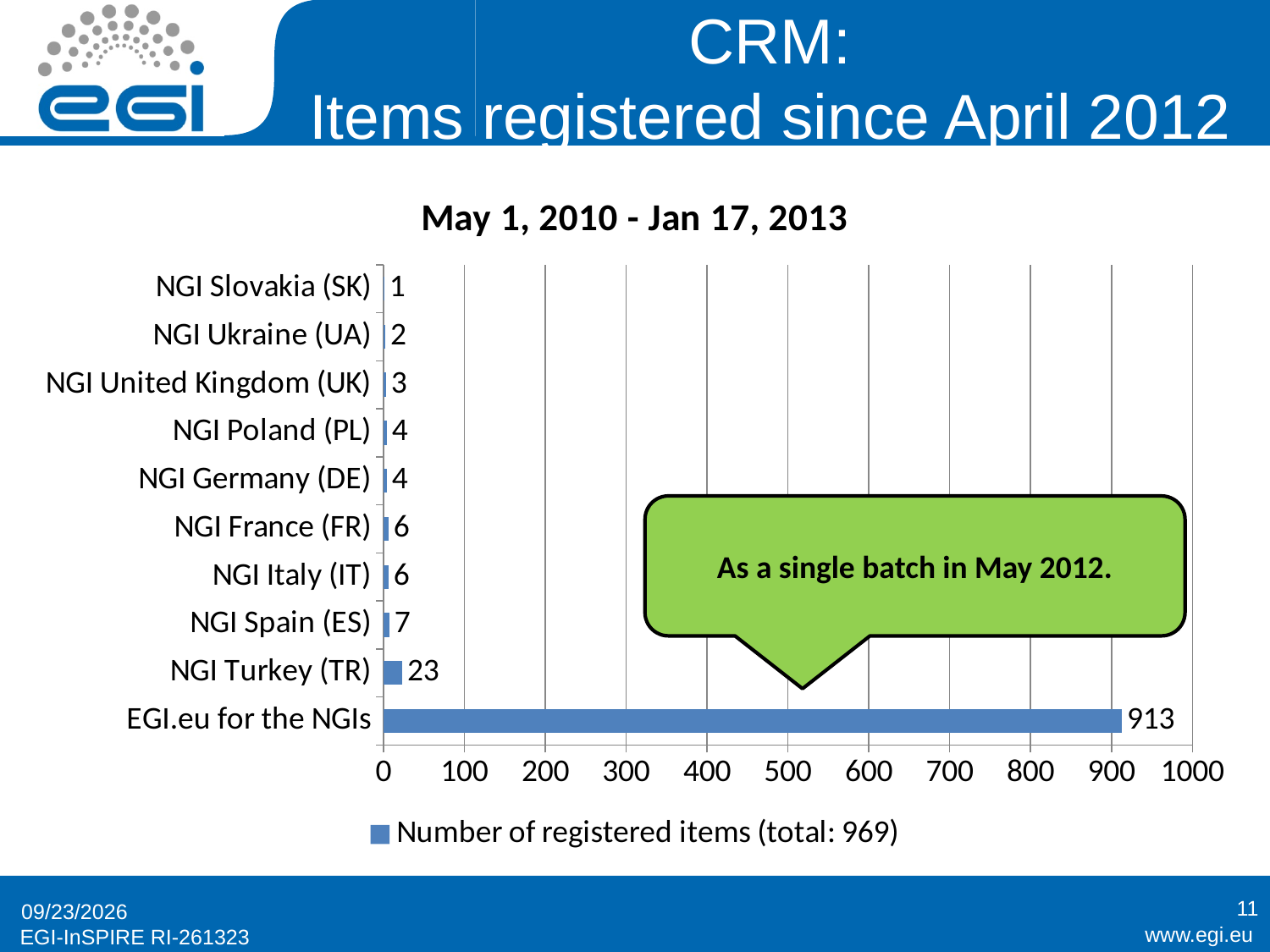
What is the value for NGI Slovakia (SK)? 1 Which is larger, the value for NGI Turkey (TR) or NGI Spain (ES)? NGI Turkey (TR) What is the value for NGI Turkey (TR)? 23 What is the value for EGI.eu for the NGIs? 913 What is the title of the chart? May 1, 2010 - Jan 17, 2013 Which category has the lowest value? NGI Slovakia (SK) How many categories are shown in the chart? 10 What is the value for NGI Spain (ES)? 7 What is the difference between the values for EGI.eu for the NGIs and NGI Turkey (TR)? 890 How many series does the legend list? 1 Which category has the highest value? EGI.eu for the NGIs What kind of chart is shown? Bar chart